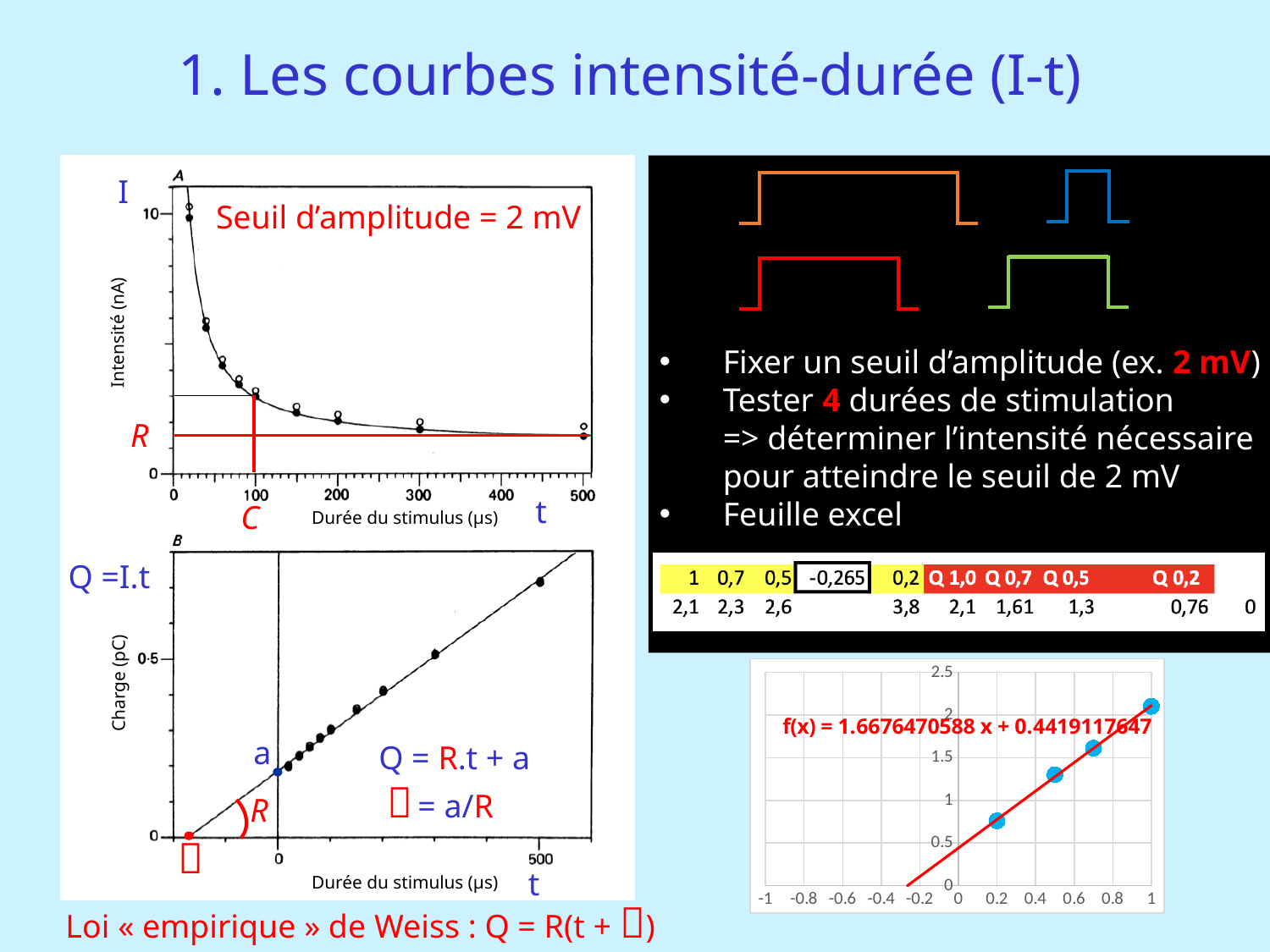
In the Excel chart at the bottom right, is the value of the point at x = 0.5 greater or less than 1? greater In the Excel scatter chart at the bottom right, what is the equation of the fitted line shown on the chart? f(x) = 1.6676470588 x + 0.4419117647 In the Excel chart at the bottom right, what is the highest value shown on the vertical axis? 2.5 In chart B at the bottom left (Charge vs Durée du stimulus), do the values rise or fall as the stimulus duration increases? rise In chart A at the top left (Intensité vs Durée du stimulus), do the values rise or fall as the stimulus duration increases? fall In the Excel chart at the bottom right, is the value of the point at x = 1 greater or less than 2? greater In chart B at the bottom left, is the charge at a stimulus duration of 500 µs greater or less than 0.5 pC? greater In the Excel chart at the bottom right, how many data points are plotted? 4 What kind of chart is the Excel chart at the bottom right of the slide? scatter chart In the Excel chart at the bottom right, do the plotted values rise or fall as x increases? rise What is the label of the vertical axis of chart A at the top left? Intensité (nA)